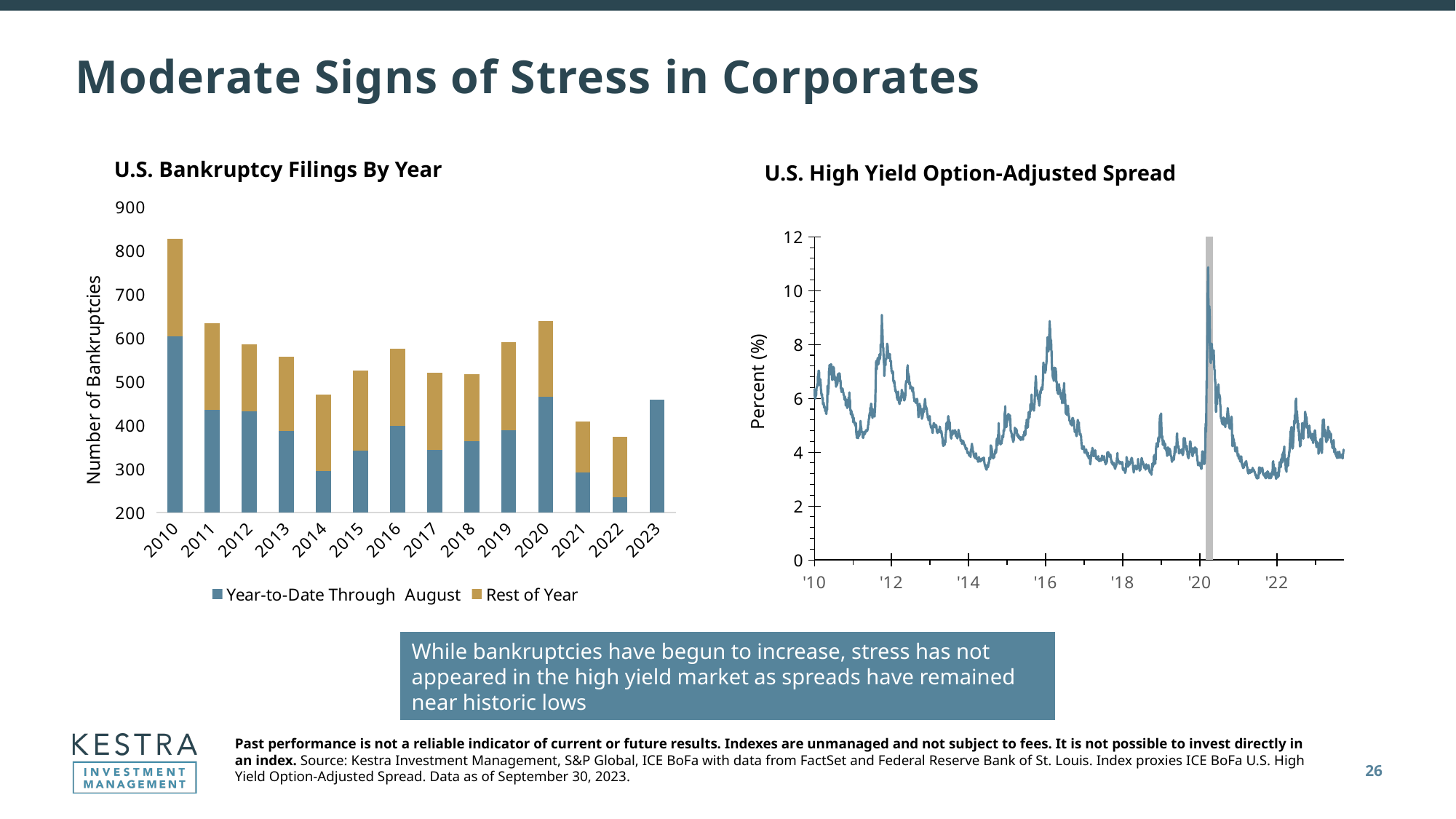
In the U.S. High Yield Option-Adjusted Spread chart, is the peak value around 2020 greater or less than 10? greater In the U.S. Bankruptcy Filings By Year chart, which year has the lowest total number of bankruptcies? 2022 What kind of chart is the U.S. High Yield Option-Adjusted Spread chart? Line chart How many series does the legend of the U.S. Bankruptcy Filings By Year chart list? 2 In the U.S. Bankruptcy Filings By Year chart, is the Year-to-Date Through August value for 2023 greater or less than 400? greater In the U.S. Bankruptcy Filings By Year chart, is the total for 2010 greater or less than 800? greater In the U.S. Bankruptcy Filings By Year chart, which is larger: the total for 2020 or the total for 2021? 2020 What is the y-axis label of the U.S. High Yield Option-Adjusted Spread chart? Percent (%) How many years are shown on the x axis of the U.S. Bankruptcy Filings By Year chart? 14 In the U.S. Bankruptcy Filings By Year chart, which year has the highest total number of bankruptcies? 2010 What kind of chart is the U.S. Bankruptcy Filings By Year chart? Stacked bar chart